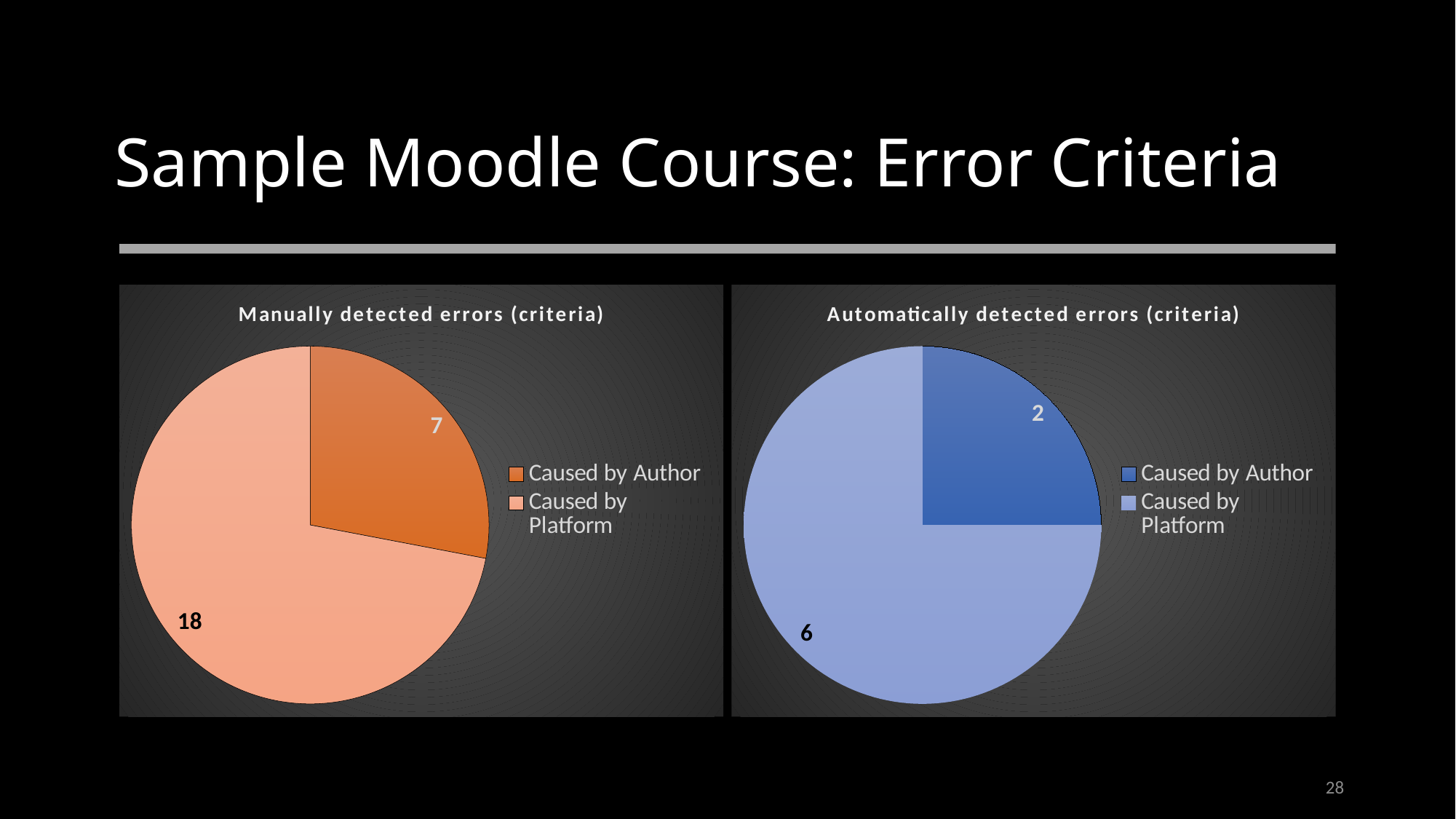
In the 'Automatically detected errors (criteria)' chart, what is the value for Caused by Platform? 6 In the 'Automatically detected errors (criteria)' chart, which category has the smallest slice? Caused by Author In the 'Automatically detected errors (criteria)' chart, what is the value for Caused by Author? 2 In the 'Manually detected errors (criteria)' chart, which category has the largest slice? Caused by Platform In the 'Manually detected errors (criteria)' chart, what is the total of all slices? 25 In the 'Automatically detected errors (criteria)' chart, what is the difference between Caused by Platform and Caused by Author? 4 In the 'Automatically detected errors (criteria)' chart, what share of the pie is Caused by Author? 25% How many categories does the legend of the 'Automatically detected errors (criteria)' chart list? 2 In the 'Manually detected errors (criteria)' chart, what is the difference between Caused by Platform and Caused by Author? 11 In the 'Manually detected errors (criteria)' chart, what is the value for Caused by Platform? 18 In the 'Manually detected errors (criteria)' chart, what is the value for Caused by Author? 7 What kind of chart is the 'Manually detected errors (criteria)' chart? Pie chart